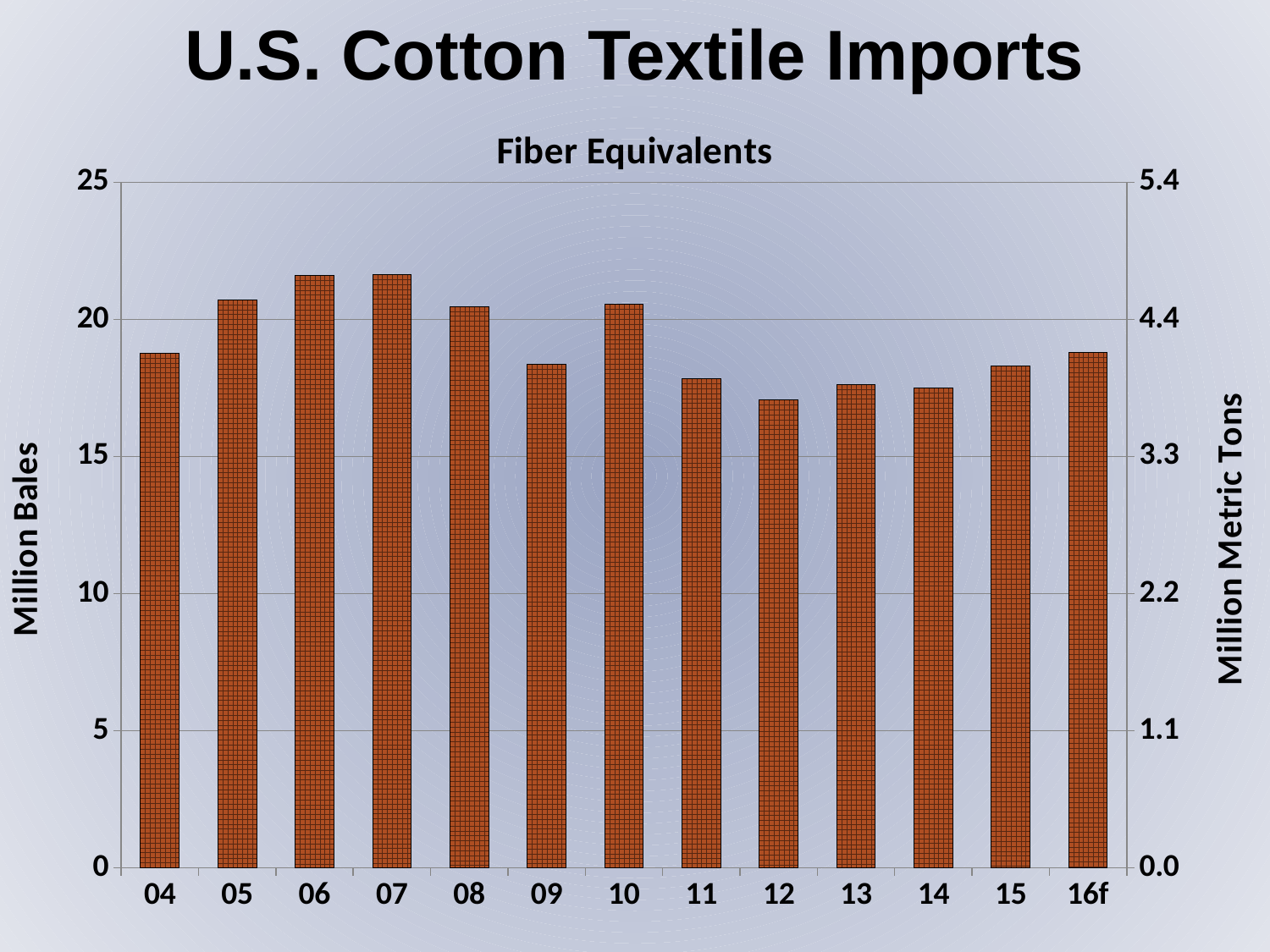
Which year has the lowest value for U.S. cotton textile imports? 12 What kind of chart is shown on the slide? bar chart Which is larger, the value for 08 or the value for 14? 08 Do the values rise or fall from 07 to 09? fall How many years (categories) are shown on the x axis? 13 Is the value for 12 greater or less than 20 million bales? less Is the value for 06 greater or less than 20 million bales? greater What is the label of the left vertical axis? Million Bales Is the value for 11 greater or less than 20 million bales? less Which is larger, the value for 05 or the value for 12? 05 What is the label of the right vertical axis? Million Metric Tons